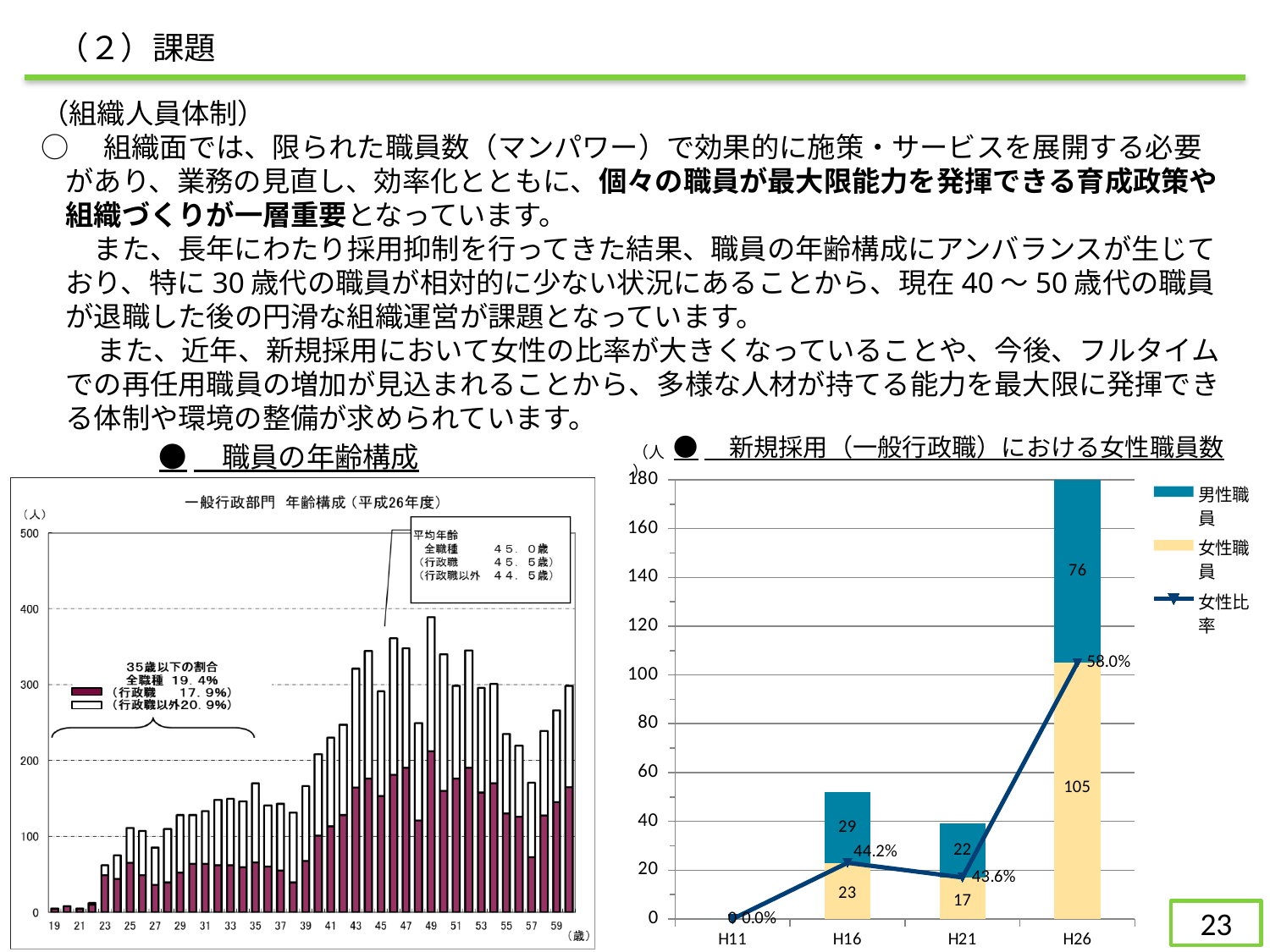
In the chart titled 新規採用（一般行政職）における女性職員数, what is the value for 男性職員 in H16? 29 In the chart titled 新規採用（一般行政職）における女性職員数, how many series does the legend list? 3 In the chart titled 新規採用（一般行政職）における女性職員数, what is the 女性比率 for H21? 43.6% In the chart titled 新規採用（一般行政職）における女性職員数, what is the total of the stacked bar for H26? 181 In the chart titled 新規採用（一般行政職）における女性職員数, what is the 女性比率 for H26? 58.0% In the chart titled 新規採用（一般行政職）における女性職員数, which is larger in H21, 男性職員 or 女性職員? 男性職員 In the chart titled 新規採用（一般行政職）における女性職員数, what is the difference between 女性職員 and 男性職員 in H26? 29 In the chart titled 新規採用（一般行政職）における女性職員数, what is the value for 女性職員 in H26? 105 In the chart titled 新規採用（一般行政職）における女性職員数, how many years are shown on the x axis? 4 In the chart titled 新規採用（一般行政職）における女性職員数, which year has the lowest 女性比率? H11 What kind of chart is the chart titled 職員の年齢構成 on the left of the slide? Bar chart In the chart titled 新規採用（一般行政職）における女性職員数, which year has the highest value for 女性職員? H26